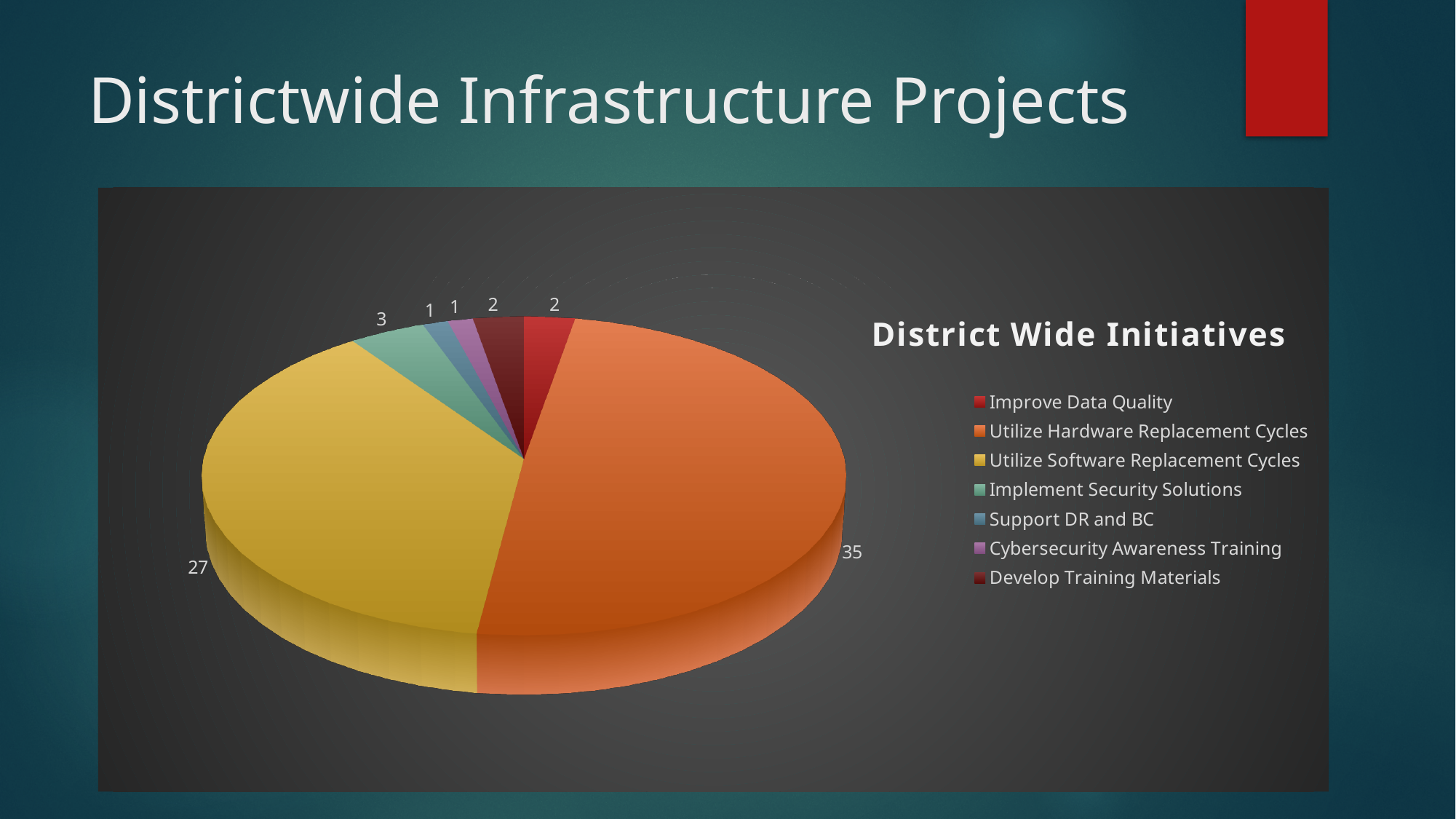
What is the value for Improve Data Quality? 2 How many categories does the legend list? 7 What type of chart is shown on the slide? pie chart What is the title of the chart? District Wide Initiatives Which category has the largest slice? Utilize Hardware Replacement Cycles What is the value for Support DR and BC? 1 Which is larger, Implement Security Solutions or Develop Training Materials? Implement Security Solutions What is the value for Implement Security Solutions? 3 What is the value for Utilize Hardware Replacement Cycles? 35 What is the difference between Utilize Hardware Replacement Cycles and Utilize Software Replacement Cycles? 8 What is the value for Utilize Software Replacement Cycles? 27 What is the total of all slices in the pie? 71